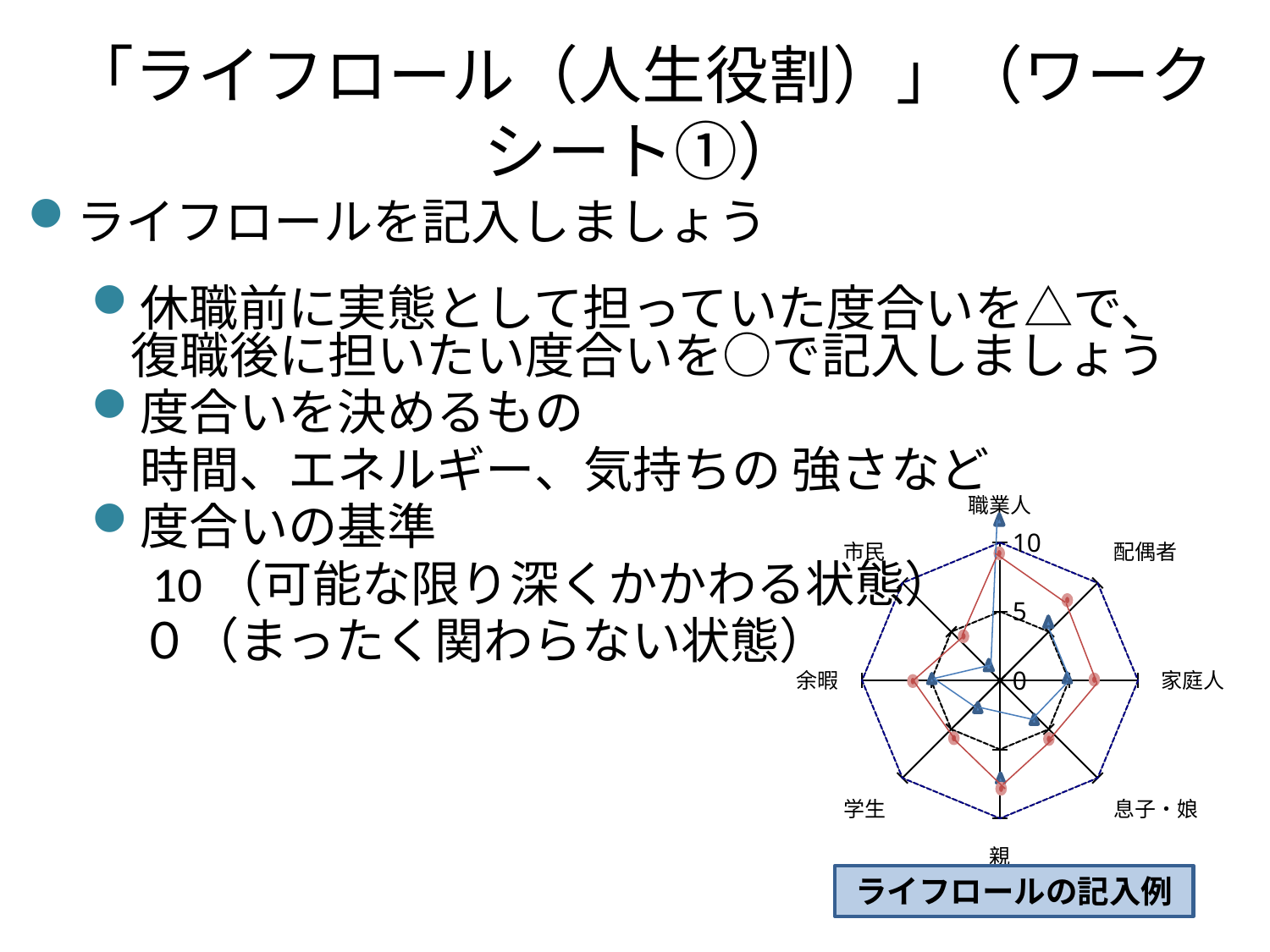
At 親, which is larger: the red circle value or the blue triangle value? red circle For which category is the blue triangle series highest? 職業人 How many categories (life roles) are plotted on the radar chart? 8 Is the red circle value for 職業人 greater or less than 5? greater Is the blue triangle value for 親 greater or less than 5? less Is the red circle value for 親 greater or less than 5? greater Which category is at the top of the radar chart? 職業人 What is the highest value shown on the radar chart's axis? 10 At 配偶者, which is larger: the red circle value or the blue triangle value? red circle What kind of chart is shown on the slide? radar chart